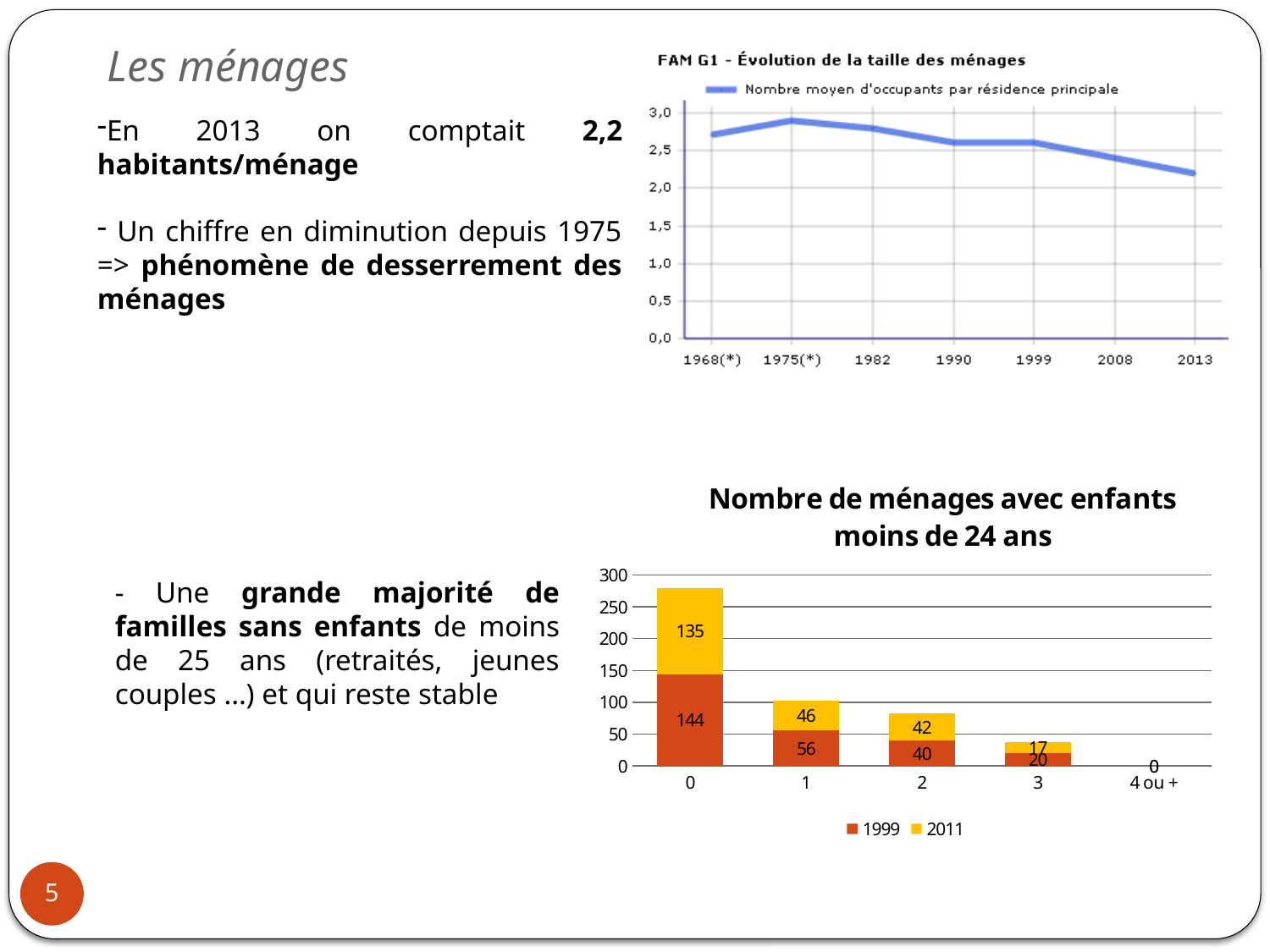
In the chart titled 'Nombre de ménages avec enfants moins de 24 ans', what is the 2011 value for the category 3? 17 In the chart titled 'Nombre de ménages avec enfants moins de 24 ans', what is the 2011 value for the category 2? 42 In the chart titled 'Nombre de ménages avec enfants moins de 24 ans', what is the difference between the 1999 and 2011 values for the category 1? 10 In the chart titled 'FAM G1 - Évolution de la taille des ménages', does the value rise or fall between 1975(*) and 2013? fall In the chart titled 'Nombre de ménages avec enfants moins de 24 ans', which is larger for the category 2: the 1999 value or the 2011 value? 2011 What kind of chart is the chart titled 'FAM G1 - Évolution de la taille des ménages'? Line chart In the chart titled 'Nombre de ménages avec enfants moins de 24 ans', what is the total of the stacked bar for the category 0? 279 In the chart titled 'Nombre de ménages avec enfants moins de 24 ans', how many categories are shown on the x axis? 5 In the chart titled 'Nombre de ménages avec enfants moins de 24 ans', how many series does the legend list? 2 In the chart titled 'Nombre de ménages avec enfants moins de 24 ans', what is the 1999 value for the category 0? 144 In the chart titled 'Nombre de ménages avec enfants moins de 24 ans', which category has the highest 1999 value? 0 In the chart titled 'FAM G1 - Évolution de la taille des ménages', is the value for 2013 greater or less than 2.5? less